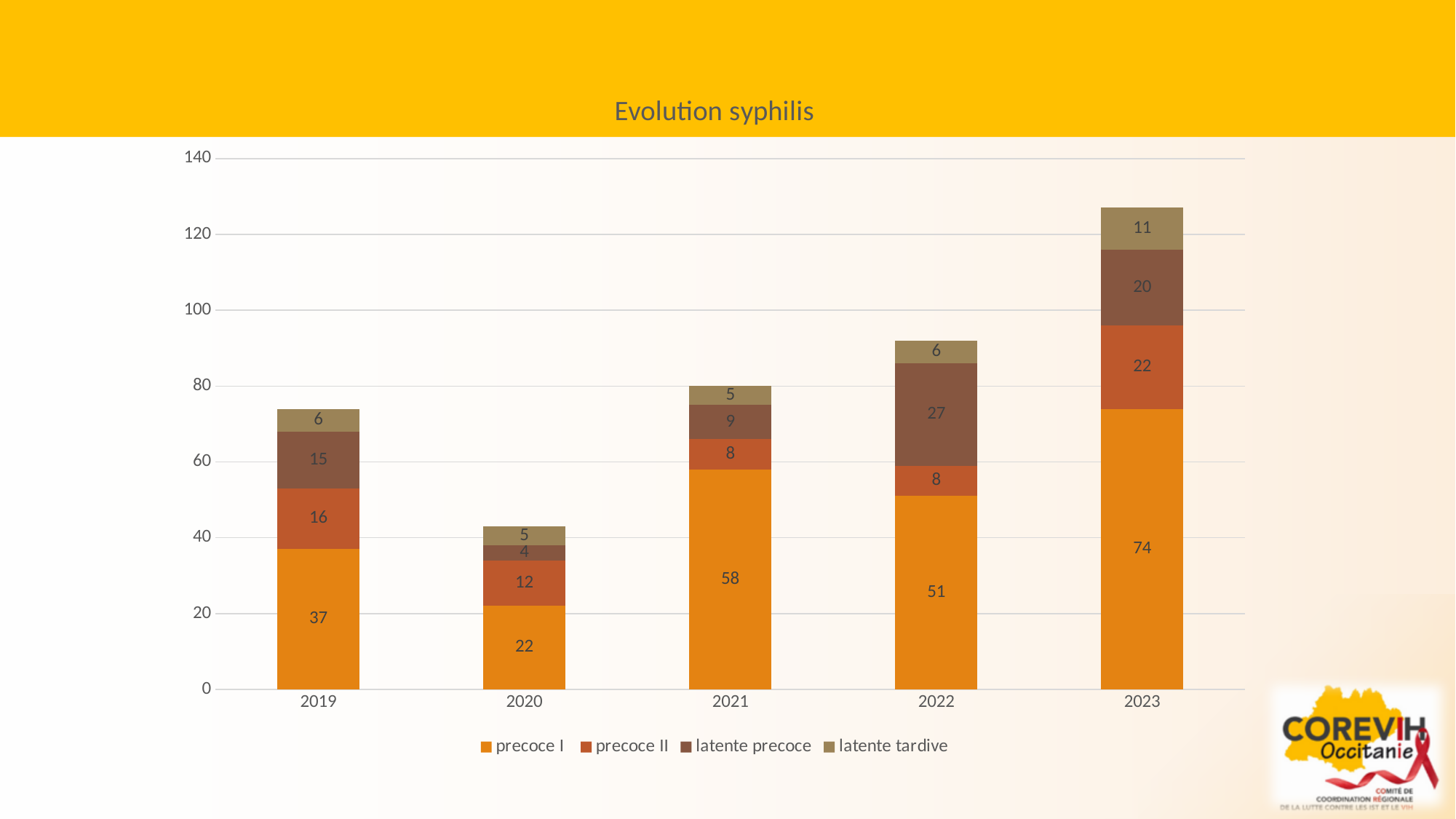
What is the value for precoce I in 2023? 74 What type of chart is shown on the slide? Stacked bar chart Is the total of the stacked bar for 2023 greater or less than 120? greater Which year has the highest value for precoce I? 2023 How many series does the legend list? 4 What is the difference between the precoce I values for 2021 and 2020? 36 How many years are shown on the x axis? 5 What is the total of the stacked bar for 2019? 74 What is the title of the chart? Evolution syphilis What is the value for precoce II in 2020? 12 Which year has the lowest value for latente precoce? 2020 What is the value for latente precoce in 2022? 27